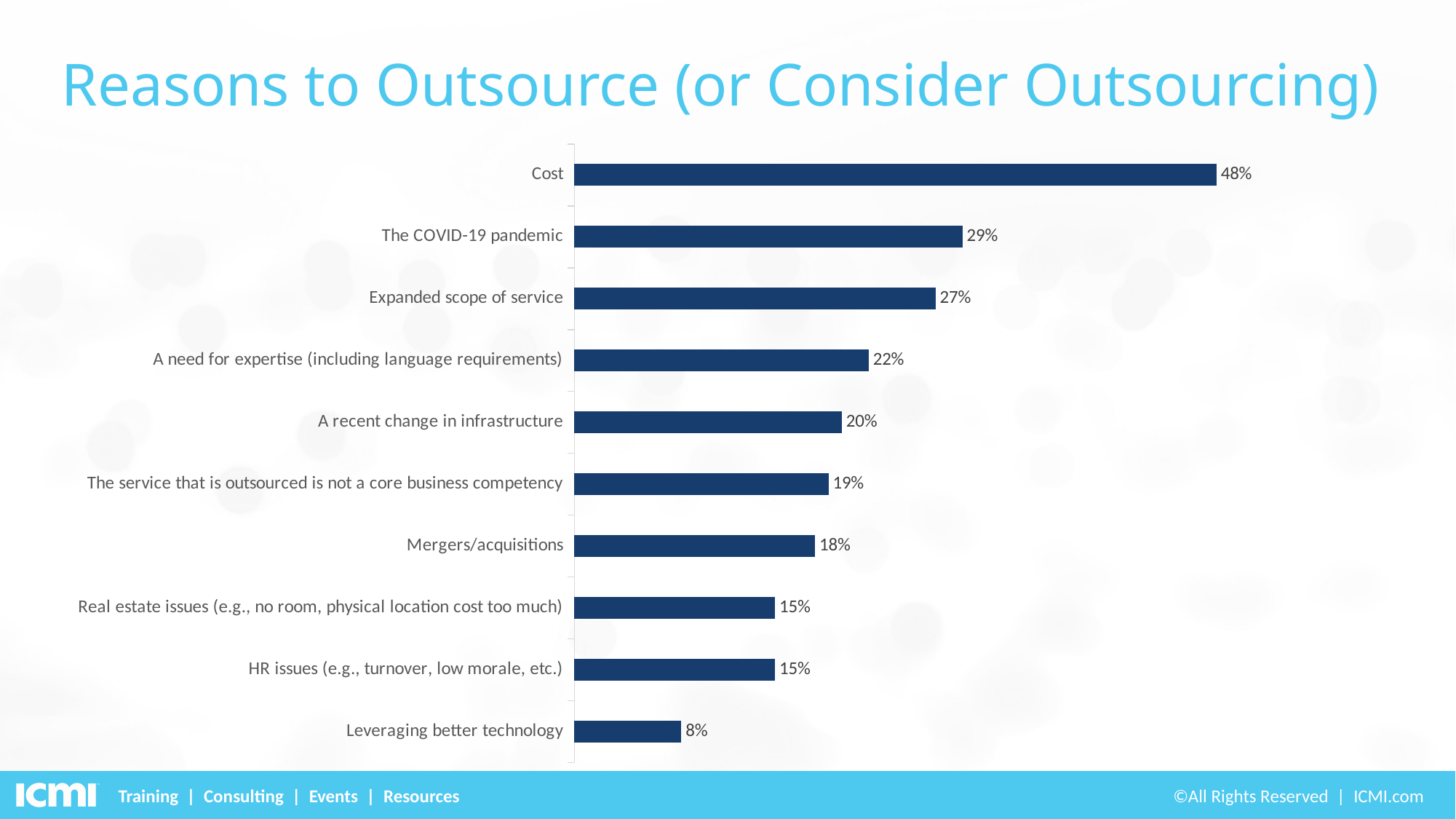
What percentage is shown for Cost? 48% What is the difference between the values for Cost and The COVID-19 pandemic? 19% Which reason has the highest percentage? Cost What is the difference between Expanded scope of service and A need for expertise (including language requirements)? 5% What percentage is shown for Mergers/acquisitions? 18% Which is larger: A recent change in infrastructure or Mergers/acquisitions? A recent change in infrastructure What is the title of the slide? Reasons to Outsource (or Consider Outsourcing) What type of chart is shown on the slide? Bar chart How many reasons are listed in the chart? 10 Which reason has the lowest percentage? Leveraging better technology What is the value for The COVID-19 pandemic? 29% What is the value for Leveraging better technology? 8%